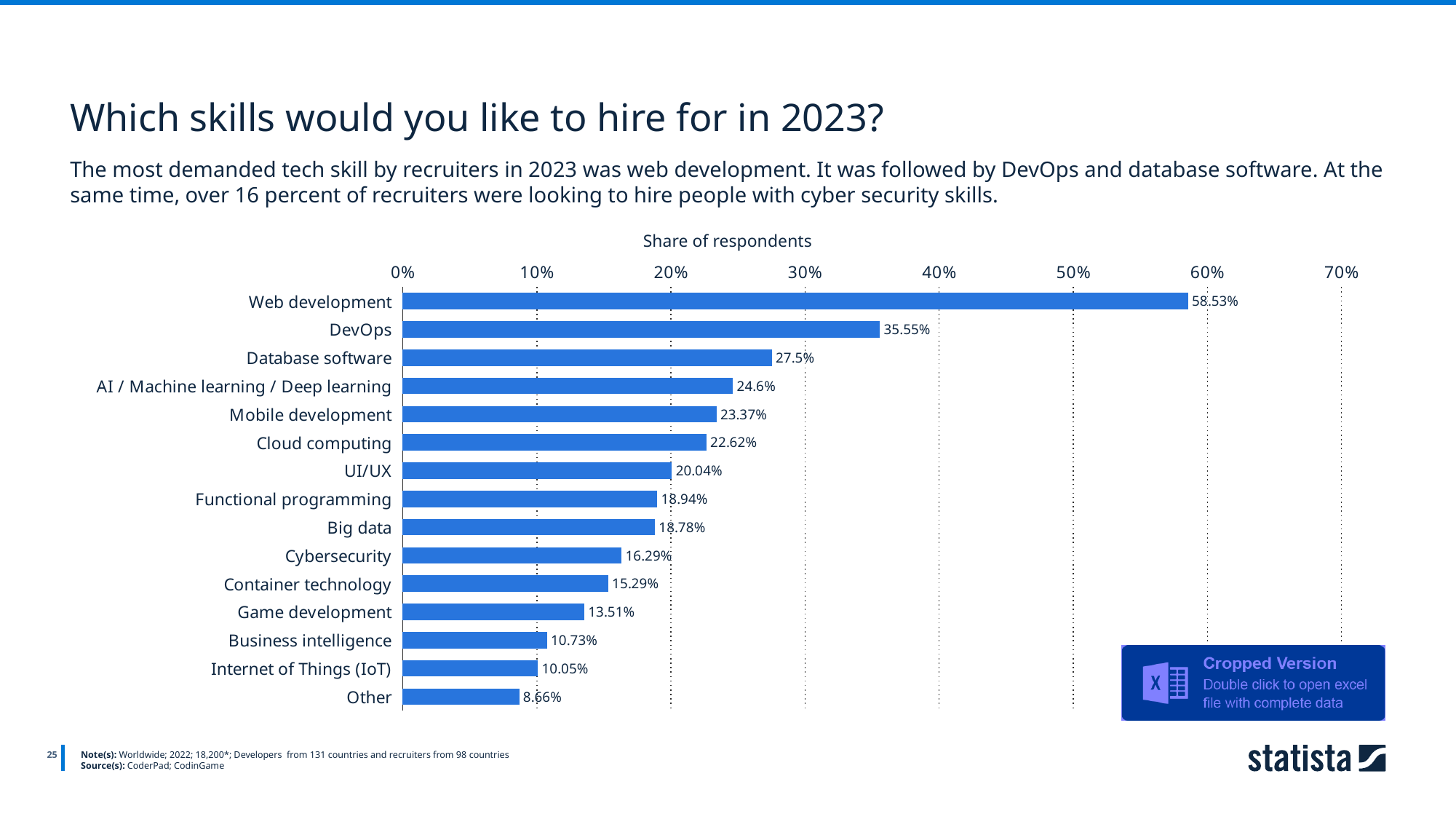
What is the value for Internet of Things (IoT)? 10.05% Is the value for Database software greater or less than 30%? less Which category has the lowest share of respondents? Other How many categories are shown in the chart? 15 What share of respondents would like to hire for Cybersecurity? 16.29% Which has a larger share of respondents, Cloud computing or UI/UX? Cloud computing What kind of chart is shown on the slide? Bar chart What is the difference in percentage points between Game development and Business intelligence? 2.78 What is the label of the value axis? Share of respondents What share of respondents would like to hire for Web development? 58.53% Which skill has the highest share of respondents? Web development What is the difference in percentage points between Web development and DevOps? 22.98